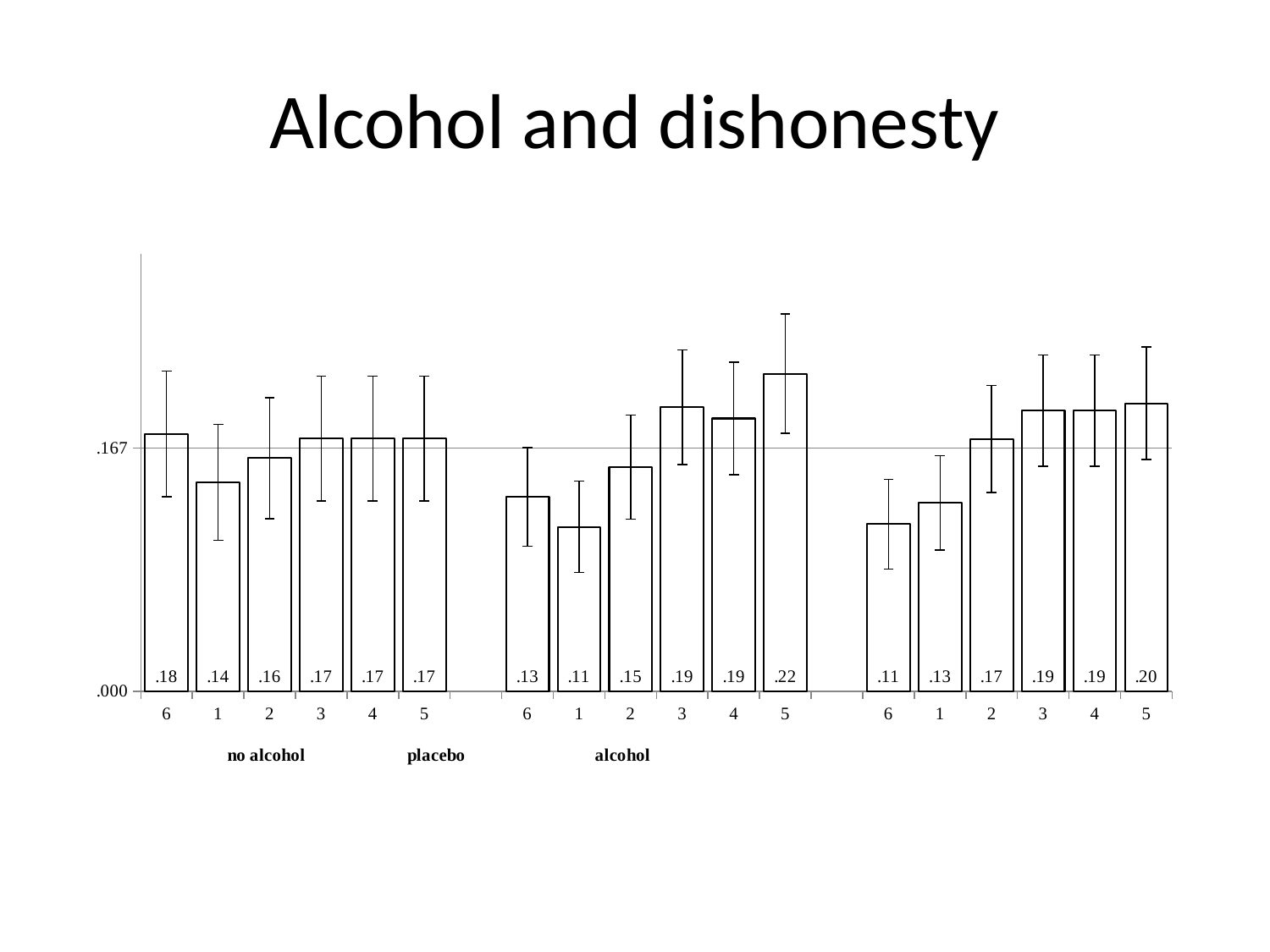
Which bar has the highest value on the chart? Outcome 5 in the placebo group (.22) What is the value for outcome 6 in the no alcohol group? .18 What kind of chart is shown on the slide? Bar chart What is the value for outcome 2 in the alcohol group? .17 What are the three group labels shown beneath the x axis? no alcohol, placebo, alcohol Is the value for outcome 1 in the placebo group greater or less than .167? less Which is larger: the value for outcome 6 in the no alcohol group or outcome 6 in the alcohol group? No alcohol (.18) How many bars are plotted on the chart in total? 18 What is the difference between the value for outcome 5 in the placebo group and outcome 5 in the no alcohol group? .05 In the placebo group, do the values rise or fall from outcome 1 to outcome 5? Rise What is the value for outcome 5 in the placebo group? .22 Within the no alcohol group, which outcome has the lowest value? 1 (.14)